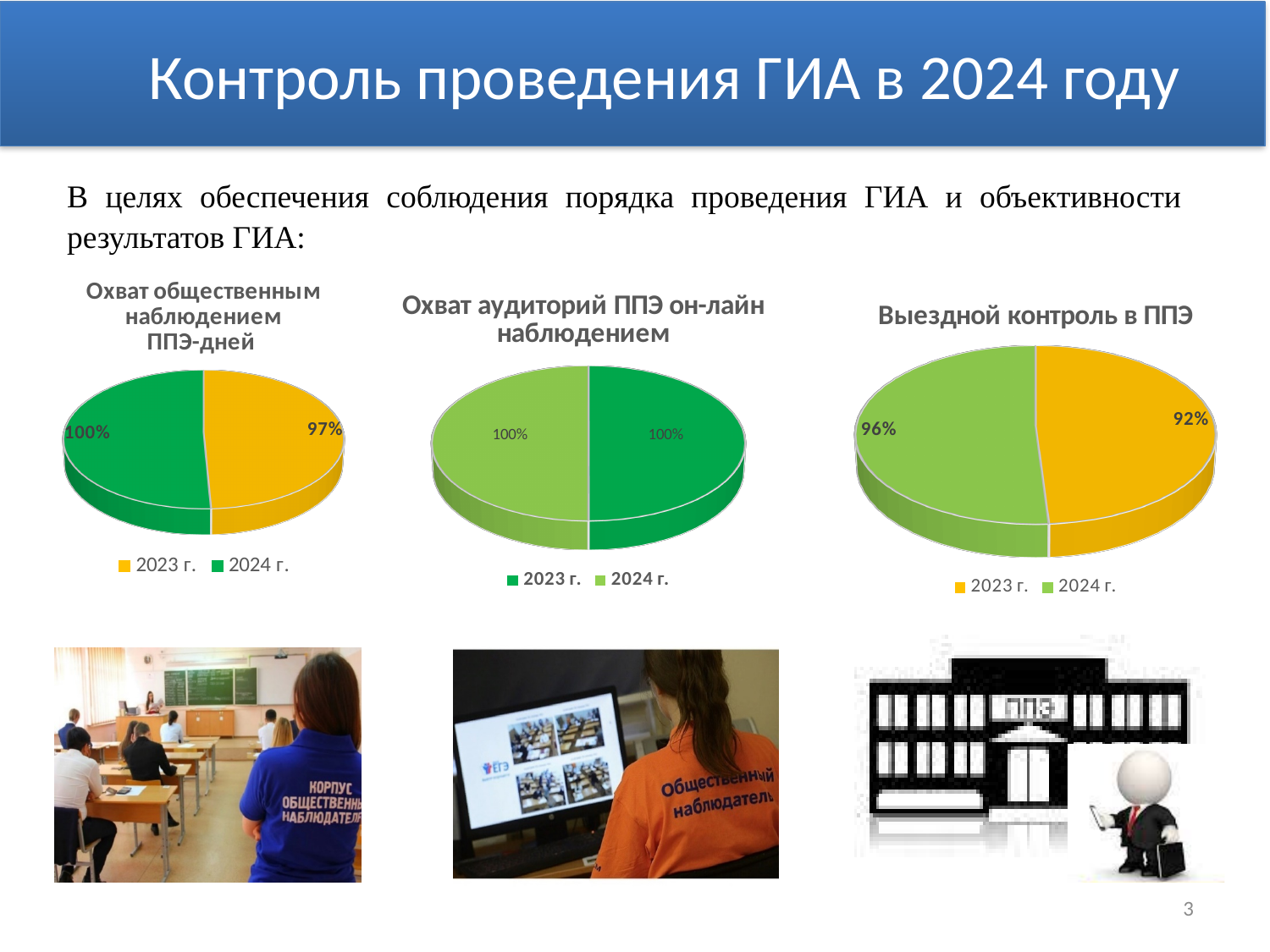
In the chart titled "Охват аудиторий ППЭ он-лайн наблюдением", what is the value for 2024 г.? 100% In the chart titled "Выездной контроль в ППЭ", what is the value for 2024 г.? 96% How many entries does the legend of the chart titled "Охват аудиторий ППЭ он-лайн наблюдением" list? 2 In the chart titled "Охват общественным наблюдением ППЭ-дней", what is the value for 2024 г.? 100% In the chart titled "Охват аудиторий ППЭ он-лайн наблюдением", what is the value for 2023 г.? 100% In the chart titled "Выездной контроль в ППЭ", which year has the lower value? 2023 г. What kind of chart is the chart titled "Выездной контроль в ППЭ"? Pie chart In the chart titled "Охват общественным наблюдением ППЭ-дней", what is the value for 2023 г.? 97% In the chart titled "Охват общественным наблюдением ППЭ-дней", what is the difference between the 2024 г. and 2023 г. values? 3% In the chart titled "Выездной контроль в ППЭ", what is the value for 2023 г.? 92% In the chart titled "Охват общественным наблюдением ППЭ-дней", which year has the higher value, 2023 г. or 2024 г.? 2024 г. In the chart titled "Выездной контроль в ППЭ", what is the difference between the 2024 г. and 2023 г. values? 4%